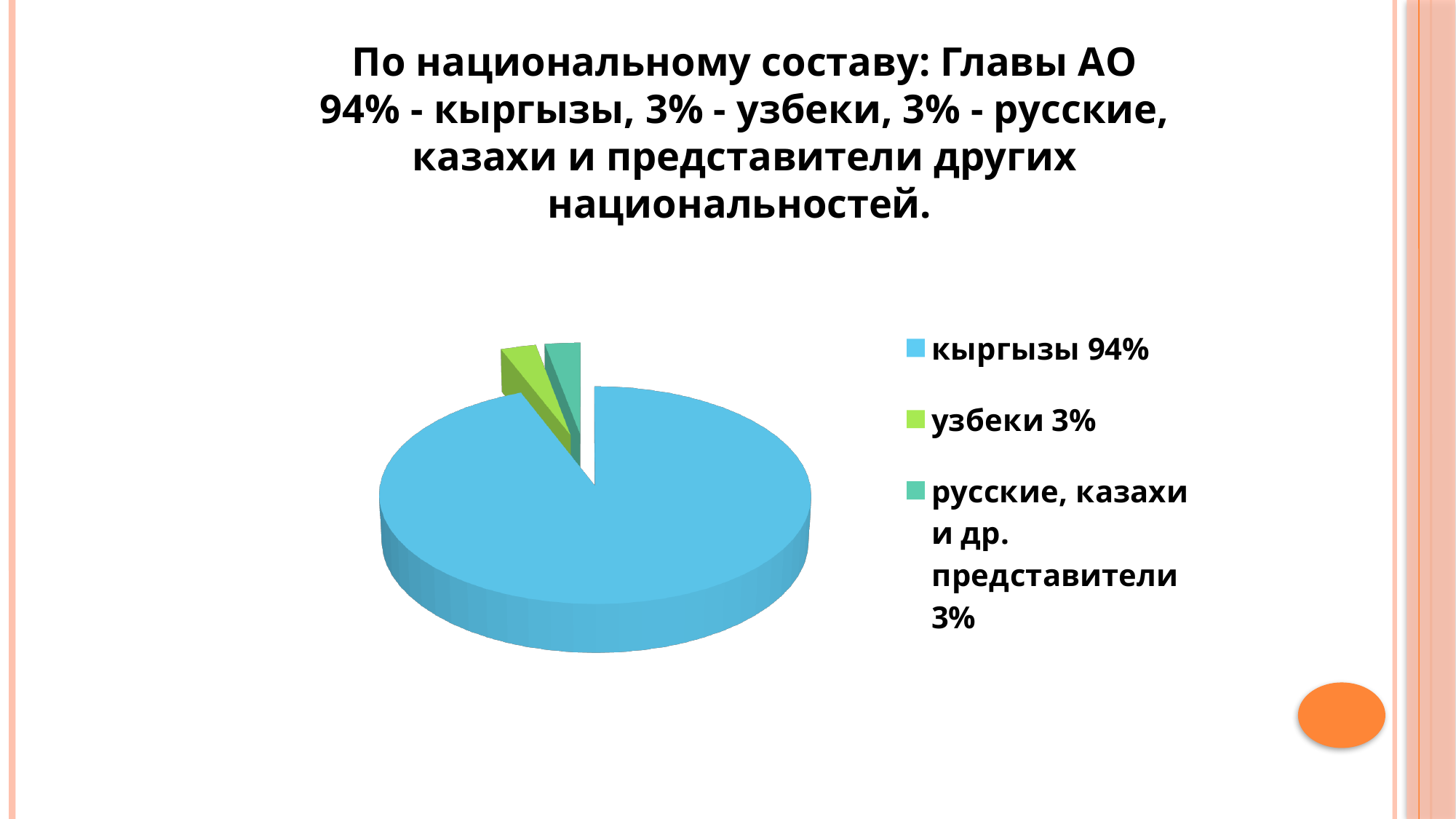
How many entries does the legend list? 3 How many slices does the pie chart have? 3 Which category has the largest slice of the pie? кыргызы What share of the pie does the slice for узбеки represent? 3% What is the difference between the share for кыргызы and the share for узбеки? 91% What colour is the slice for узбеки? green Which is larger, the slice for кыргызы or the slice for узбеки? кыргызы What share of the pie does the slice for кыргызы represent? 94% What colour is the slice for кыргызы? blue What kind of chart is shown on the slide? pie chart What is the value shown for русские, казахи и др. представители? 3%